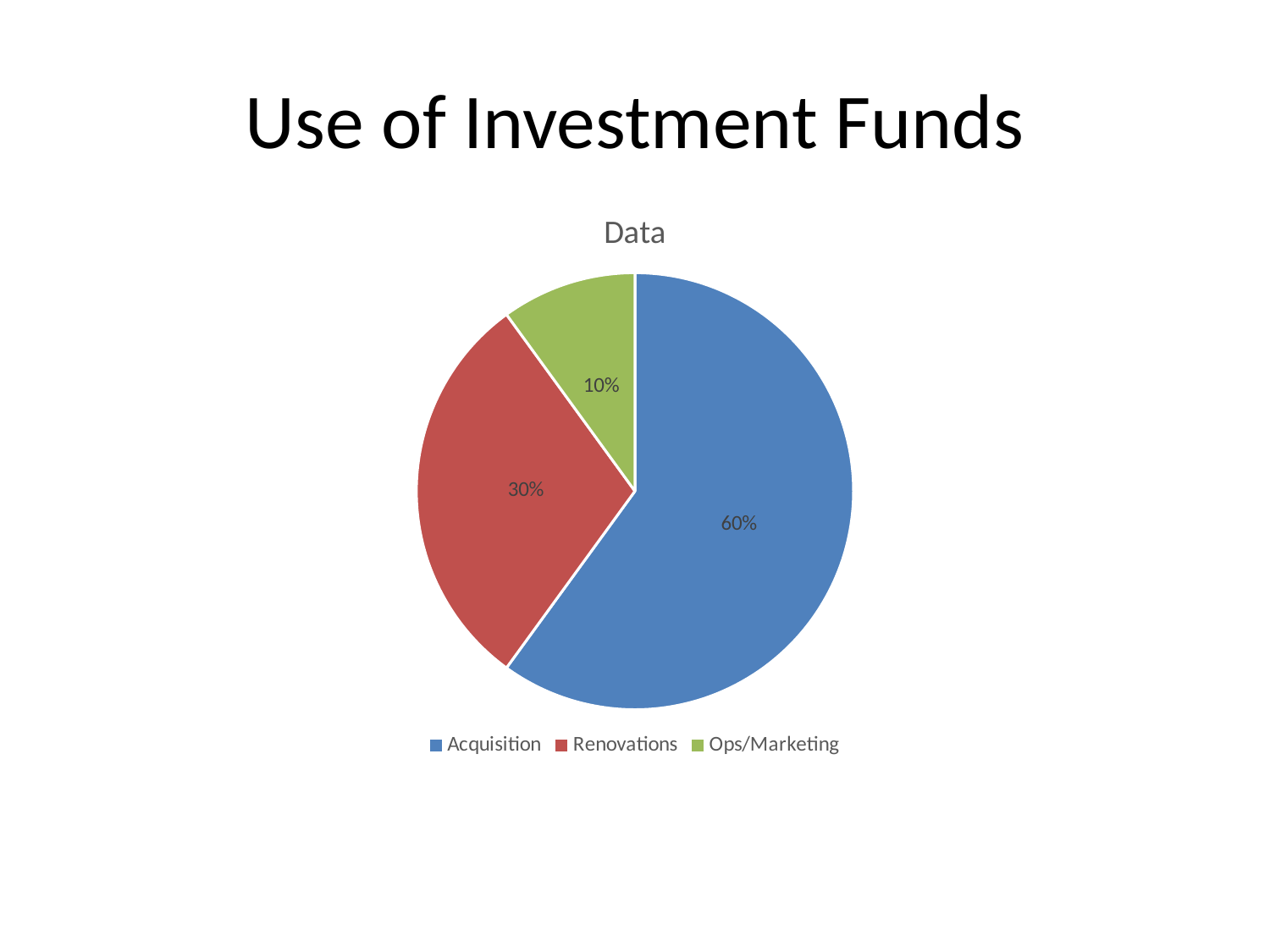
What is the difference in percentage points between Renovations and Ops/Marketing? 20 Which category has the largest slice of the pie? Acquisition What share of the pie does Acquisition take? 60% What is the difference in percentage points between Acquisition and Renovations? 30 What share of the pie does Renovations take? 30% Which is larger, the Renovations slice or the Ops/Marketing slice? Renovations What kind of chart is shown on the slide? pie chart What is the title shown above the pie chart? Data What share of the pie does Ops/Marketing take? 10% Which category has the smallest slice of the pie? Ops/Marketing How many categories does the pie chart have? 3 What colour is the Renovations slice? red